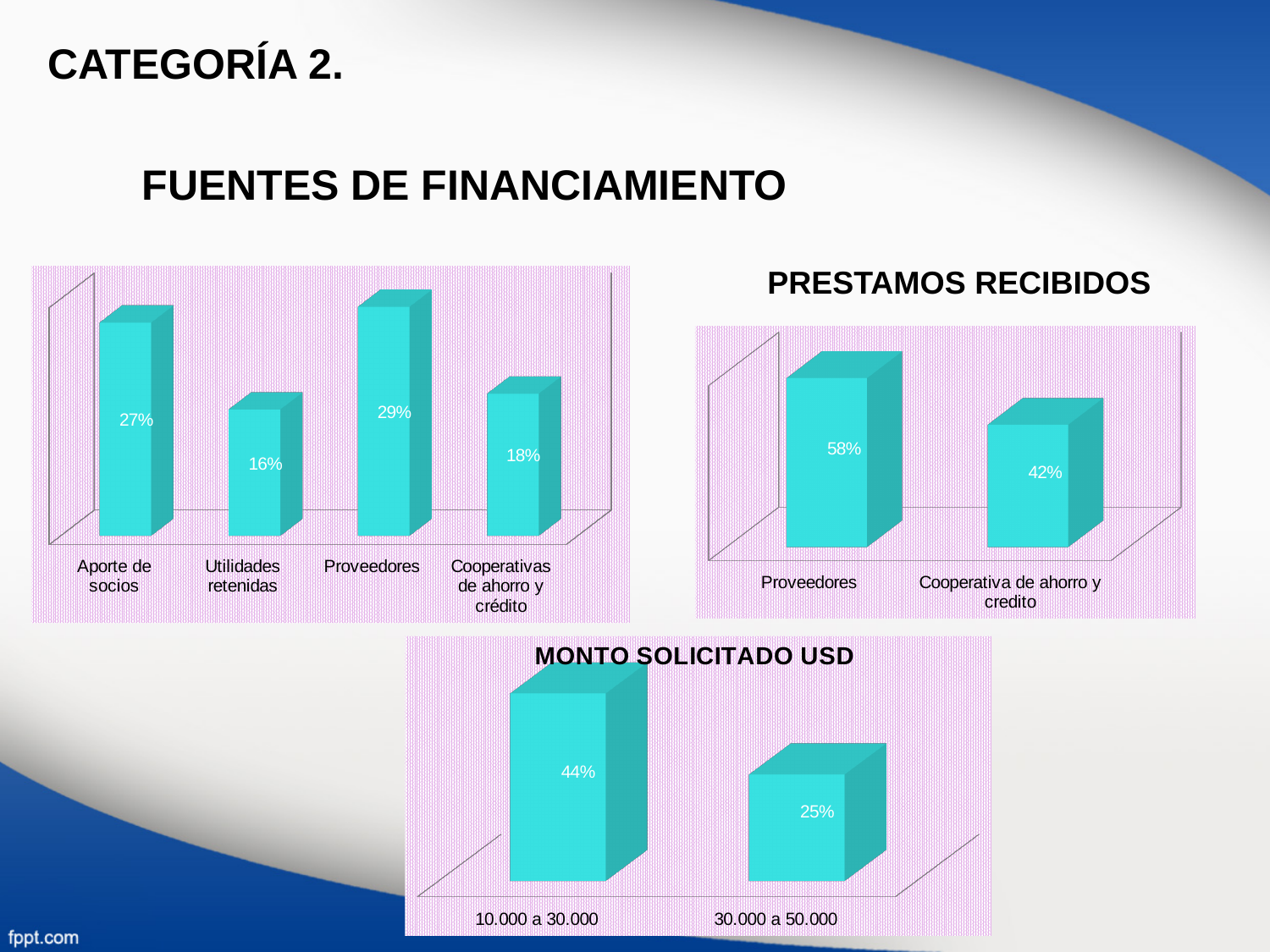
In the FUENTES DE FINANCIAMIENTO chart, what is the value for Proveedores? 29% In the PRESTAMOS RECIBIDOS chart, which is larger, Proveedores or Cooperativa de ahorro y credito? Proveedores In the FUENTES DE FINANCIAMIENTO chart, what is the value for Utilidades retenidas? 16% In the FUENTES DE FINANCIAMIENTO chart, what is the difference between Aporte de socios and Cooperativas de ahorro y crédito? 9% In the MONTO SOLICITADO USD chart, what is the value for 30.000 a 50.000? 25% How many categories are shown in the FUENTES DE FINANCIAMIENTO chart? 4 What type of chart is the MONTO SOLICITADO USD chart? Bar chart In the FUENTES DE FINANCIAMIENTO chart, which category has the highest value? Proveedores In the FUENTES DE FINANCIAMIENTO chart, which category has the lowest value? Utilidades retenidas In the PRESTAMOS RECIBIDOS chart, what is the value for Proveedores? 58% In the PRESTAMOS RECIBIDOS chart, what is the difference between Proveedores and Cooperativa de ahorro y credito? 16% In the MONTO SOLICITADO USD chart, what is the value for 10.000 a 30.000? 44%